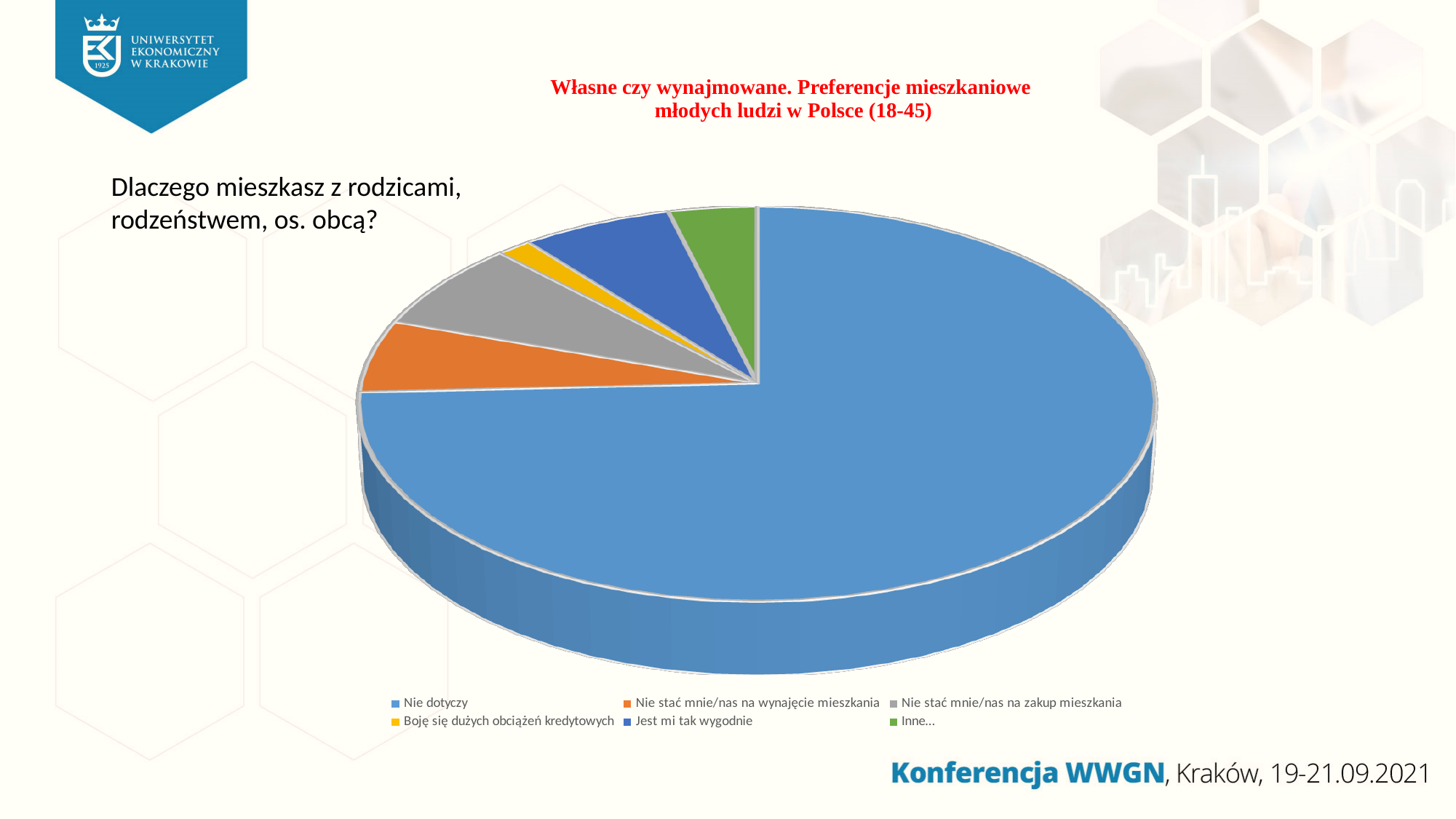
Which slice is larger: "Jest mi tak wygodnie" or "Boję się dużych obciążeń kredytowych"? Jest mi tak wygodnie Which slice is larger: "Nie stać mnie/nas na wynajęcie mieszkania" or "Boję się dużych obciążeń kredytowych"? Nie stać mnie/nas na wynajęcie mieszkania Which category has the smallest slice of the pie chart? Boję się dużych obciążeń kredytowych What question does the pie chart answer, according to the text next to it? Dlaczego mieszkasz z rodzicami, rodzeństwem, os. obcą? Which category has the largest slice of the pie chart? Nie dotyczy Which slice is larger: "Nie stać mnie/nas na zakup mieszkania" or "Inne..."? Nie stać mnie/nas na zakup mieszkania What kind of chart is shown on the slide? pie chart How many categories does the pie chart show? 6 What colour is the "Inne..." slice in the pie chart? green